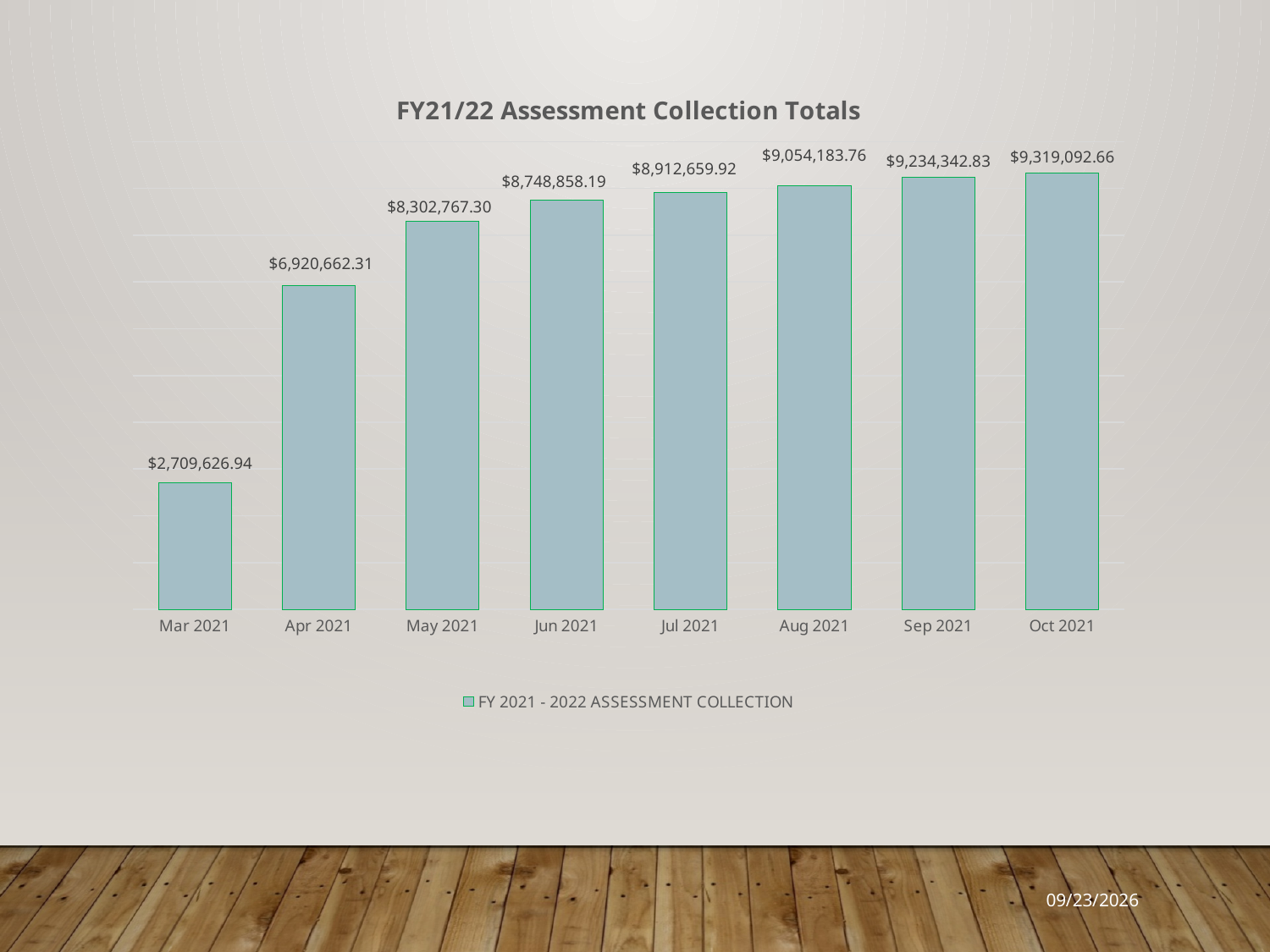
What is the value for Mar 2021? $2,709,626.94 What is the value for Sep 2021? $9,234,342.83 Which month has the highest value? Oct 2021 Which month has the lowest value? Mar 2021 What is the difference between the values for Apr 2021 and Mar 2021? $4,211,035.37 What kind of chart is shown? Bar chart What is the value for Jun 2021? $8,748,858.19 What is the difference between the values for Oct 2021 and Sep 2021? $84,749.83 How many series does the legend list? 1 How many months are shown on the x axis? 8 Do the values rise or fall from Mar 2021 to Oct 2021? Rise Which is larger, the value for May 2021 or the value for Jul 2021? Jul 2021